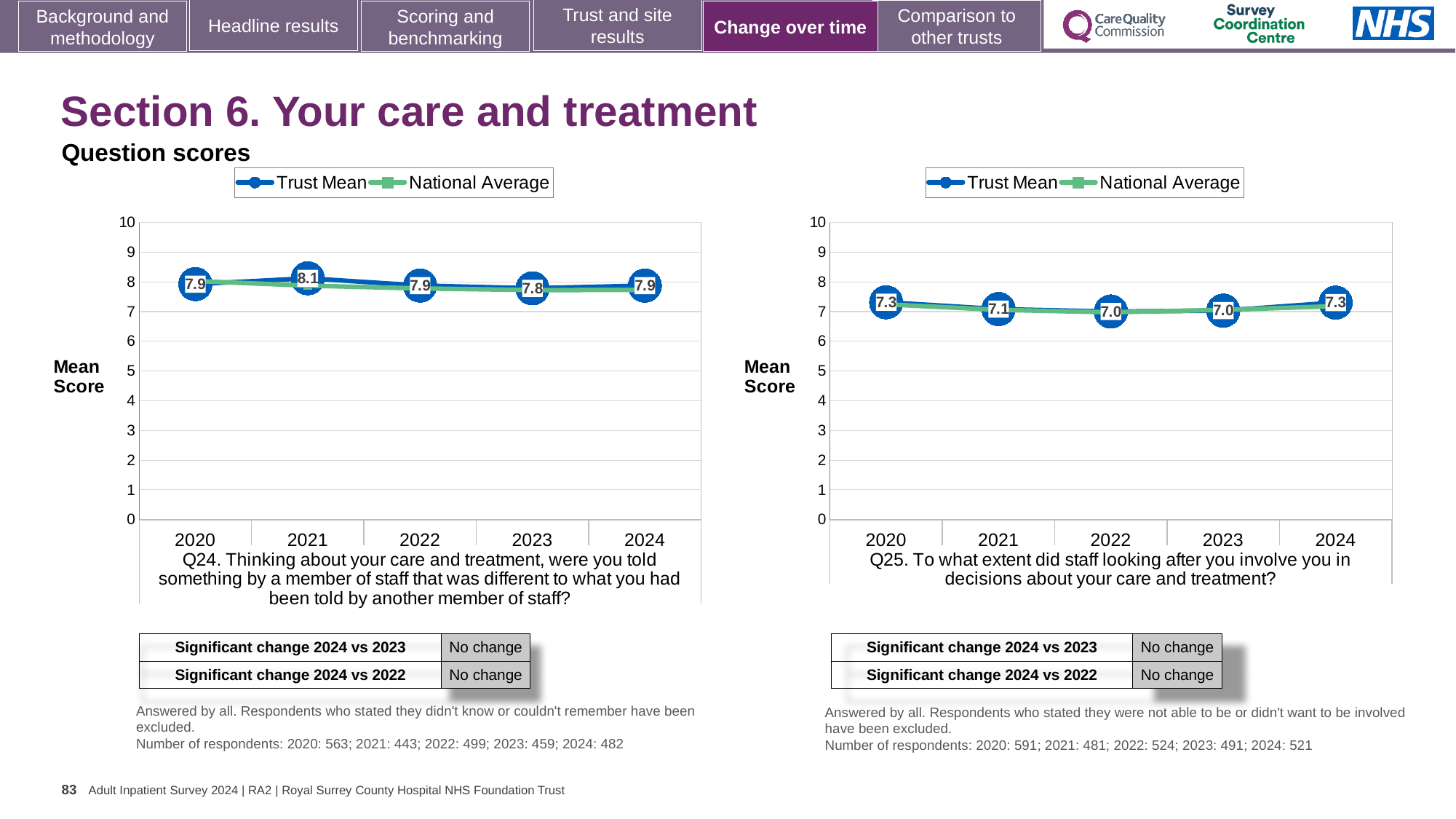
How many years are plotted on the x axis of the right chart (Q25)? 5 In the left chart (Q24), what is the Trust Mean score for 2021? 8.1 In the left chart (Q24), which year has the highest Trust Mean score? 2021 In the right chart (Q25), what is the Trust Mean score for 2024? 7.3 In the right chart (Q25), is the National Average for 2022 greater or less than 8? less How many series does the legend of the left chart (Q24) list? 2 In the left chart (Q24), what is the difference between the Trust Mean scores for 2021 and 2023? 0.3 In the left chart (Q24), what is the Trust Mean score for 2023? 7.8 In the right chart (Q25), what is the Trust Mean score for 2021? 7.1 What type of chart is used for Q25 on the right? Line chart In the left chart (Q24), which year has the lowest Trust Mean score? 2023 In the right chart (Q25), is the Trust Mean score for 2020 greater or less than the score for 2022? greater